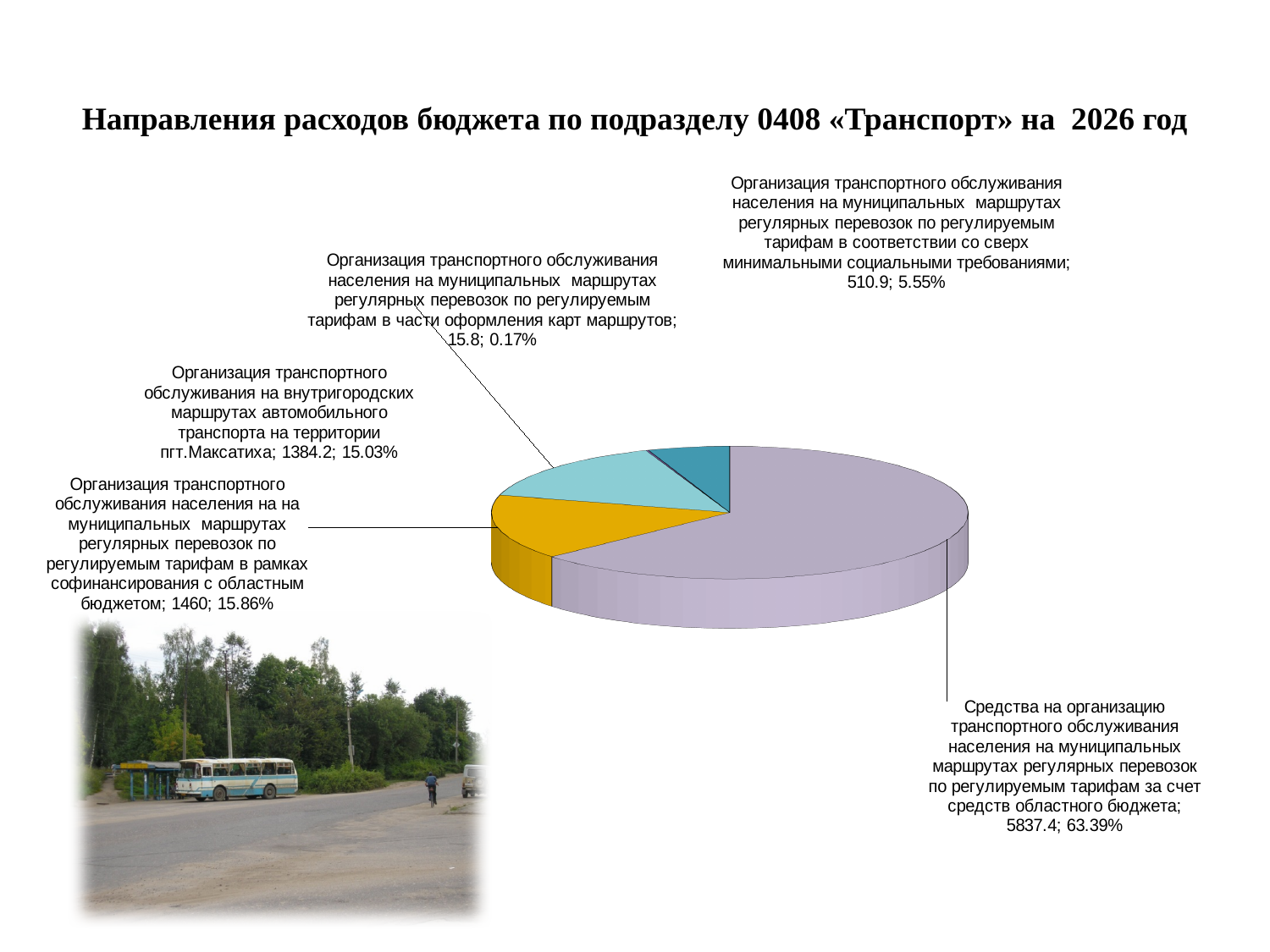
How many slices does the pie chart have? 5 What is the value for 'Организация транспортного обслуживания на внутригородских маршрутах автомобильного транспорта на территории пгт.Максатиха'? 1384.2 Which is larger: the value for 'в рамках софинансирования с областным бюджетом' or the value for 'в соответствии со сверх минимальными социальными требованиями'? в рамках софинансирования с областным бюджетом What kind of chart is shown on the slide? pie chart What percentage is shown for the slice 'в части оформления карт маршрутов'? 0.17% Which slice of the pie chart is the smallest? Организация транспортного обслуживания населения на муниципальных маршрутах регулярных перевозок по регулируемым тарифам в части оформления карт маршрутов Which slice of the pie chart is the largest? Средства на организацию транспортного обслуживания населения на муниципальных маршрутах регулярных перевозок по регулируемым тарифам за счет средств областного бюджета What is the difference between the value for 'в рамках софинансирования с областным бюджетом' (1460) and the value for 'пгт.Максатиха' (1384.2)? 75.8 What is the value for the slice 'в соответствии со сверх минимальными социальными требованиями'? 510.9 What share of the pie does the slice for expenses 'за счет средств областного бюджета' represent? 63.39% What is the value for the slice 'Средства на организацию транспортного обслуживания населения на муниципальных маршрутах регулярных перевозок по регулируемым тарифам за счет средств областного бюджета'? 5837.4 What is the title of the slide containing the pie chart? Направления расходов бюджета по подразделу 0408 «Транспорт» на 2026 год